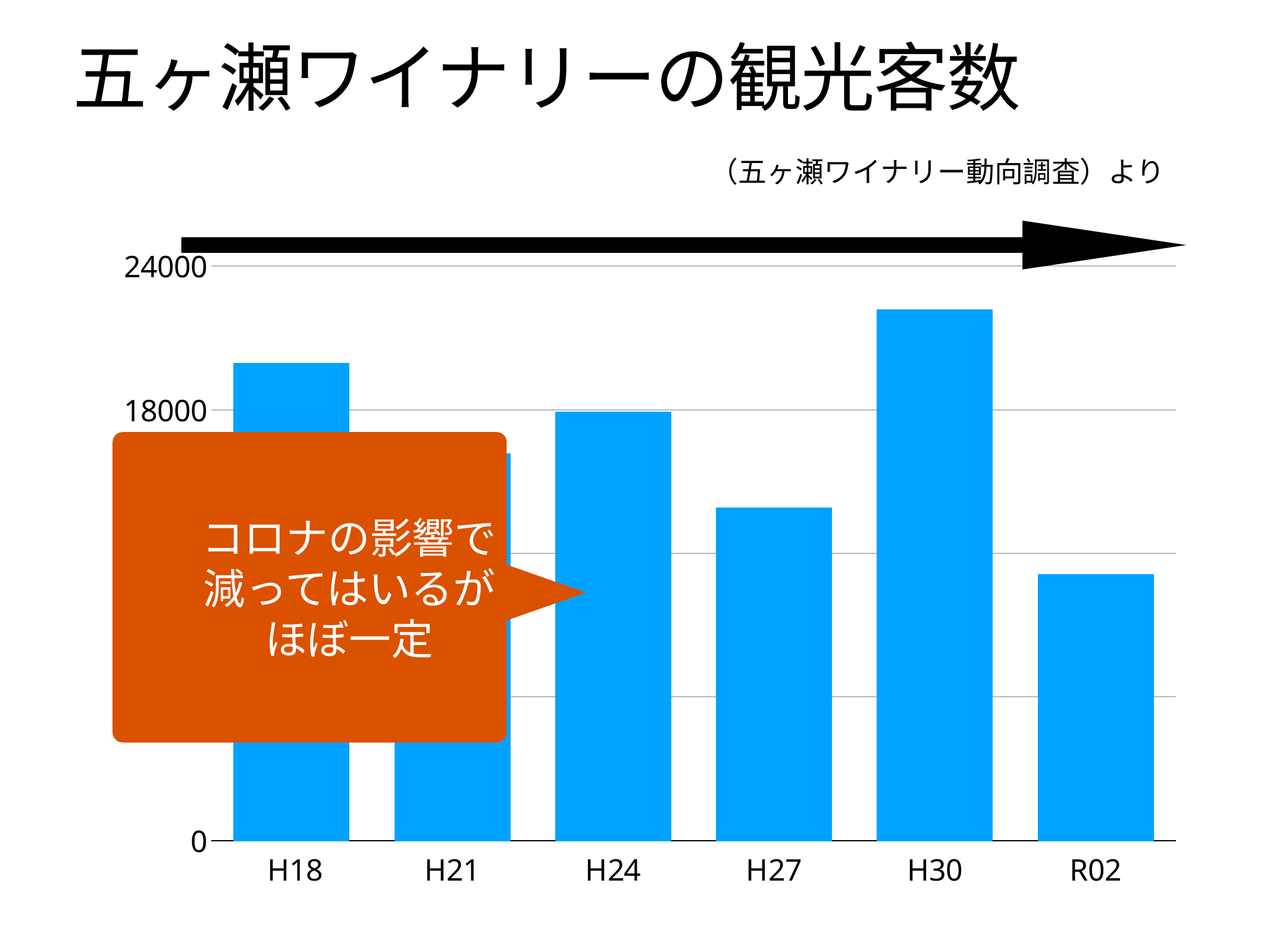
Is the value for H30 greater or less than 24000? less Is the value for H27 greater or less than 18000? less Which year has the highest bar in the chart? H30 What is the title of the slide containing the chart? 五ヶ瀬ワイナリーの観光客数 What kind of chart is shown on the slide? bar chart How many categories (years) are shown on the x axis of the chart? 6 What is the highest value labelled on the y axis of the chart? 24000 Which year has the lowest bar in the chart? R02 Which is larger, the value for H30 or the value for R02? H30 Which is larger, the value for H18 or the value for H27? H18 Is the value for R02 greater or less than 18000? less